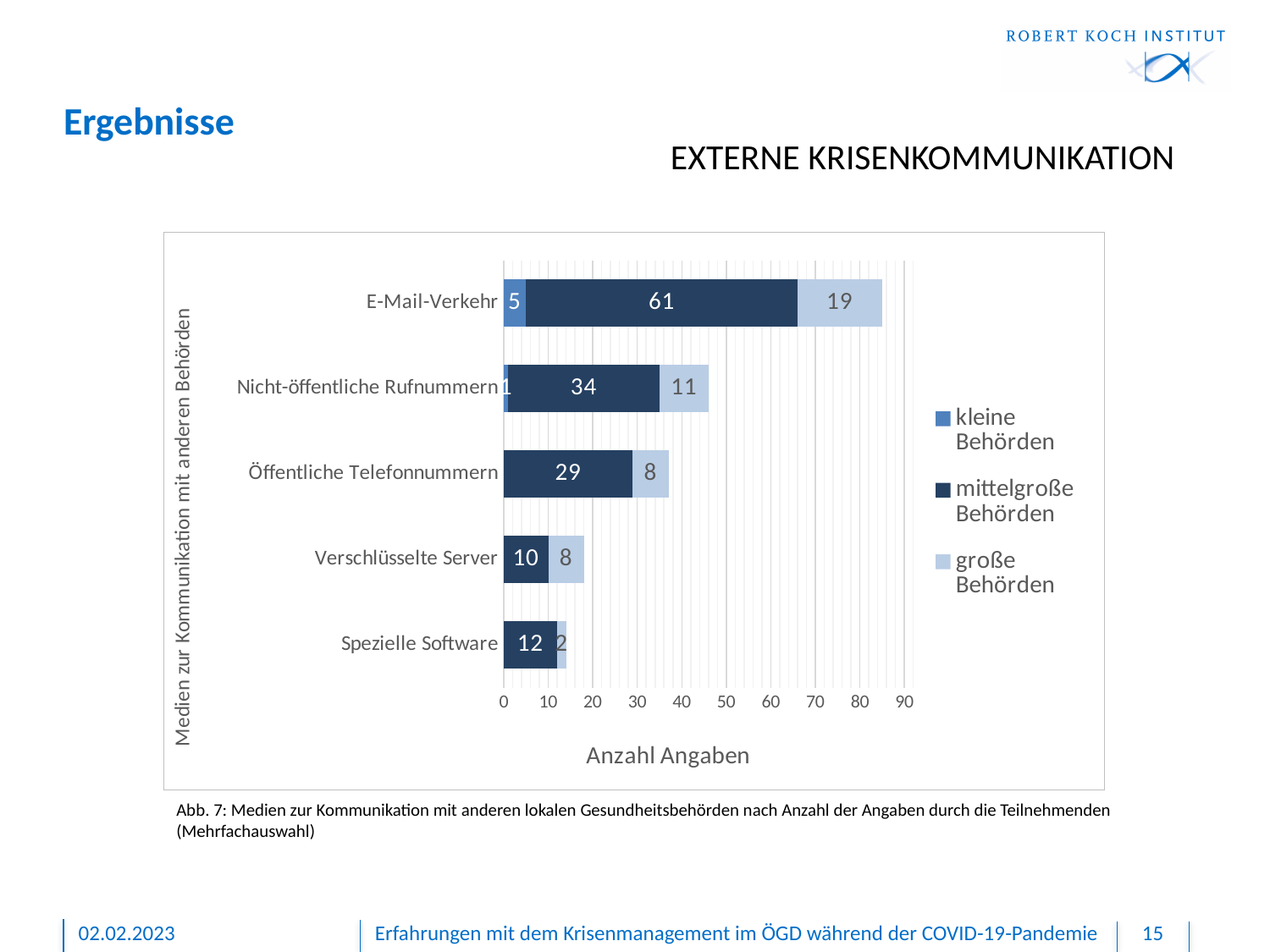
How many categories are shown on the y axis of the chart? 5 What is the value for mittelgroße Behörden in the E-Mail-Verkehr bar? 61 Which category has the highest value for mittelgroße Behörden? E-Mail-Verkehr What is the value for mittelgroße Behörden in the Verschlüsselte Server bar? 10 What is the difference between the mittelgroße Behörden values for E-Mail-Verkehr and Nicht-öffentliche Rufnummern? 27 How many series does the legend list? 3 Which has the larger große Behörden value, E-Mail-Verkehr or Öffentliche Telefonnummern? E-Mail-Verkehr Which category has the lowest value for große Behörden? Spezielle Software What is the value for kleine Behörden in the E-Mail-Verkehr bar? 5 What is the value for große Behörden in the Nicht-öffentliche Rufnummern bar? 11 What is the total of the stacked bar for E-Mail-Verkehr? 85 Is the total length of the Öffentliche Telefonnummern bar greater or less than 40? less